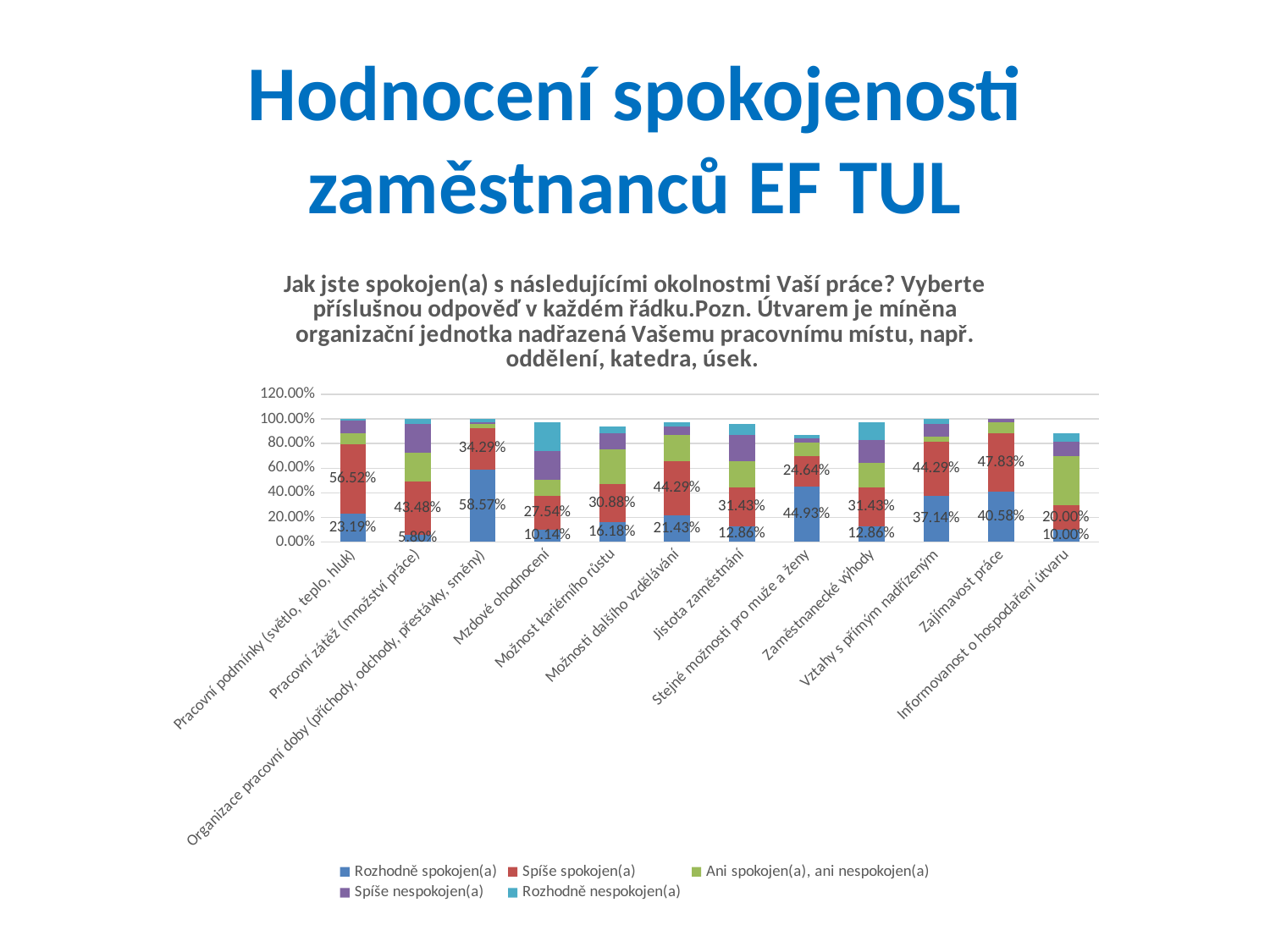
What is the value of "Rozhodně spokojen(a)" for "Mzdové ohodnocení"? 10.14% What is the value of "Rozhodně spokojen(a)" for "Zajímavost práce"? 40.58% Which is larger for "Stejné možnosti pro muže a ženy": "Rozhodně spokojen(a)" or "Spíše spokojen(a)"? Rozhodně spokojen(a) Which category has the highest "Rozhodně spokojen(a)" value? Organizace pracovní doby (příchody, odchody, přestávky, směny) What is the value of "Spíše spokojen(a)" for "Informovanost o hospodaření útvaru"? 20.00% Which legend entry is shown in light blue? Rozhodně nespokojen(a) What kind of chart is shown on the slide? Stacked bar chart What is the difference between the "Spíše spokojen(a)" and "Rozhodně spokojen(a)" values for "Pracovní zátěž (množství práce)"? 37.68% How many series does the legend list? 5 How many categories are shown on the x axis? 12 Which category has the lowest "Rozhodně spokojen(a)" value? Pracovní zátěž (množství práce) What is the value of "Spíše spokojen(a)" for "Pracovní podmínky (světlo, teplo, hluk)"? 56.52%